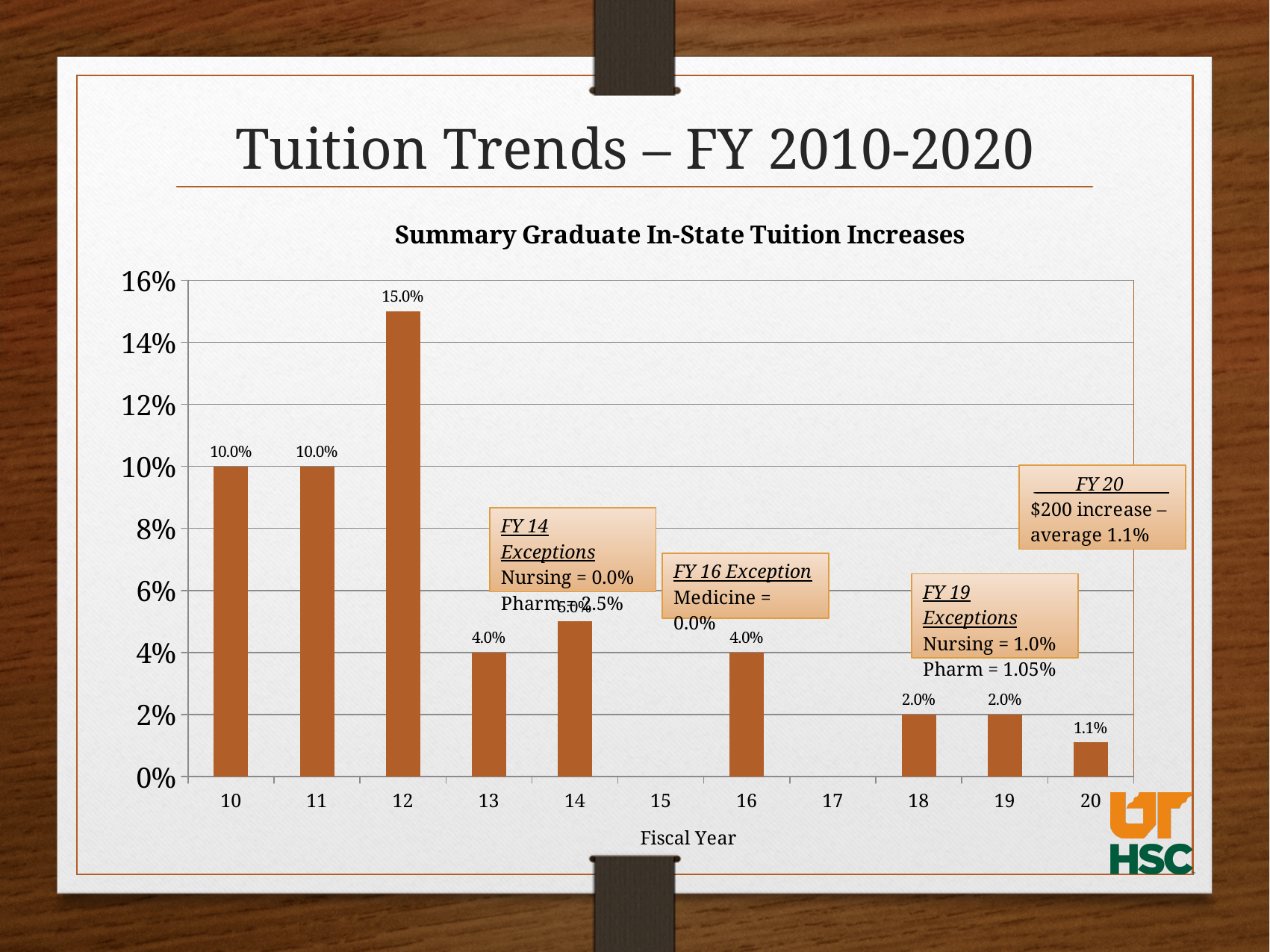
What kind of chart is shown on the slide? bar chart What is the tuition increase shown for fiscal year 16? 4.0% How many fiscal years are labelled on the x axis? 11 Is the value for fiscal year 12 greater or less than 14%? greater What is the tuition increase shown for fiscal year 12? 15.0% Which is larger, the tuition increase for fiscal year 11 or fiscal year 18? fiscal year 11 What is the tuition increase shown for fiscal year 20? 1.1% What is the title of the chart? Summary Graduate In-State Tuition Increases What is the difference between the tuition increase in fiscal year 12 and fiscal year 13? 11.0% Which fiscal year has the highest tuition increase? 12 Among the fiscal years with a bar, which has the lowest tuition increase? 20 Do the tuition increases generally rise or fall from fiscal year 12 to fiscal year 20? fall